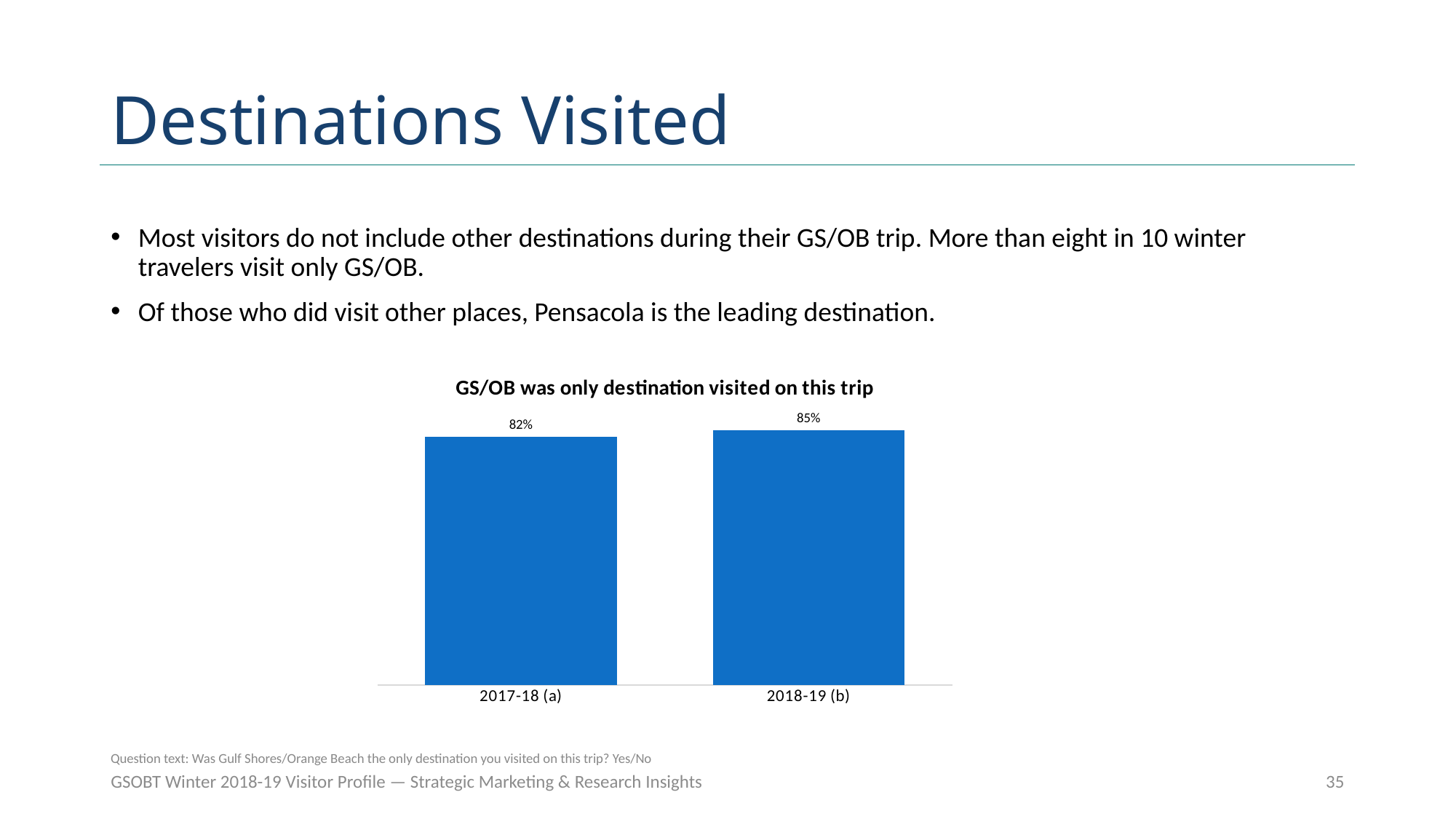
What is the difference between the values for 2018-19 (b) and 2017-18 (a)? 3% How many categories are shown in the chart? 2 What is the value for 2017-18 (a)? 82% Which category has the lowest value? 2017-18 (a) What is the title of the chart? GS/OB was only destination visited on this trip What colour are the bars in the chart? Blue Which is larger, the value for 2017-18 (a) or 2018-19 (b)? 2018-19 (b) What kind of chart is shown on the slide? Bar chart What is the value for 2018-19 (b)? 85% Which category has the highest value? 2018-19 (b) Do the values rise or fall from 2017-18 (a) to 2018-19 (b)? Rise